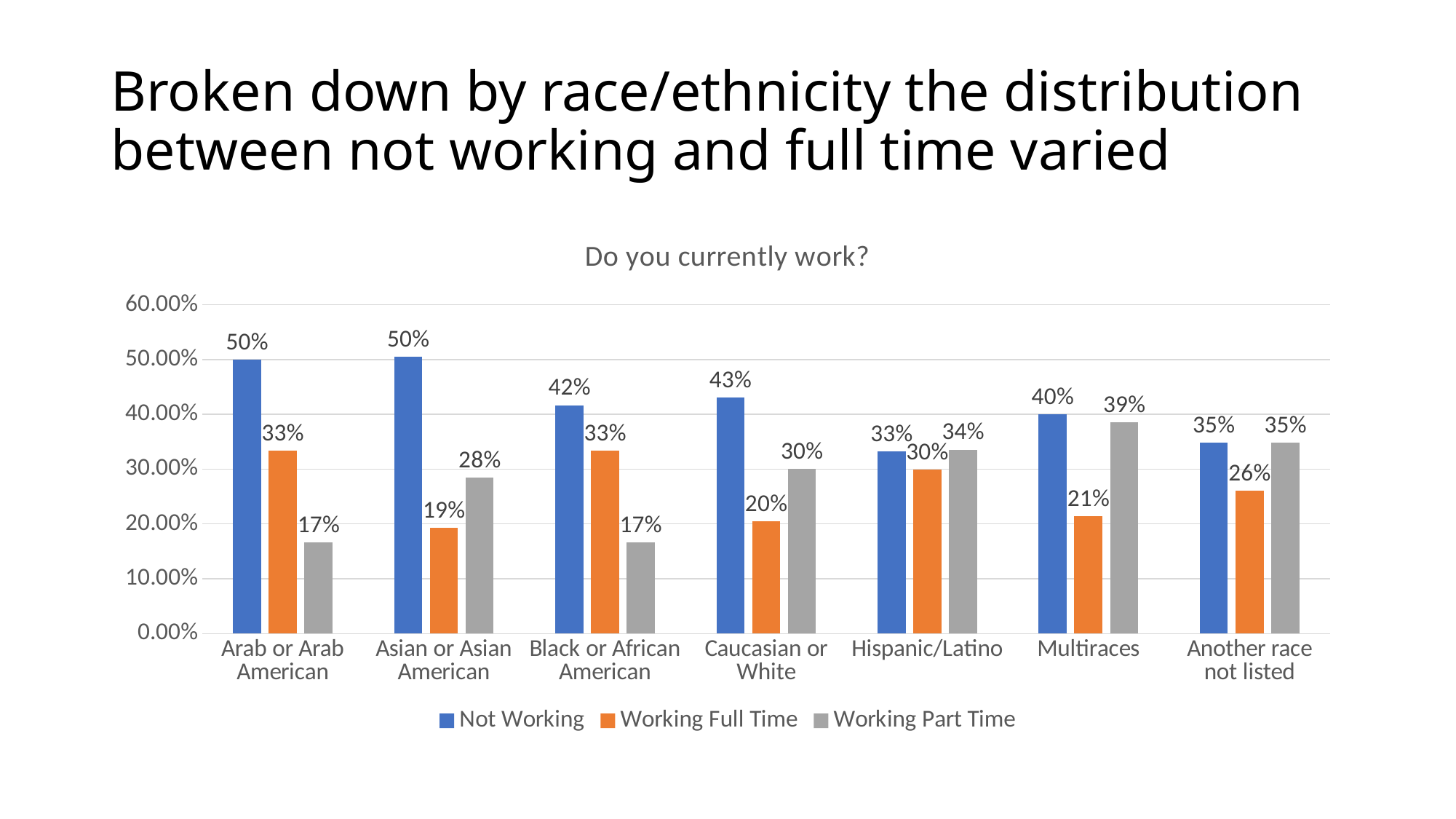
How many series does the legend list? 3 Which category has the highest Working Part Time value? Multiraces Is the Not Working value for Caucasian or White greater or less than 40.00%? greater Which is larger for Hispanic/Latino: Working Full Time or Working Part Time? Working Part Time What is the Not Working value for Black or African American? 42% What is the title of the chart? Do you currently work? What is the Working Full Time value for Caucasian or White? 20% How many race/ethnicity categories are shown on the x axis? 7 What is the Working Part Time value for Multiraces? 39% What kind of chart is shown? Bar chart Which category has the lowest Working Full Time value? Asian or Asian American What is the difference between the Not Working and Working Full Time values for Arab or Arab American? 17%